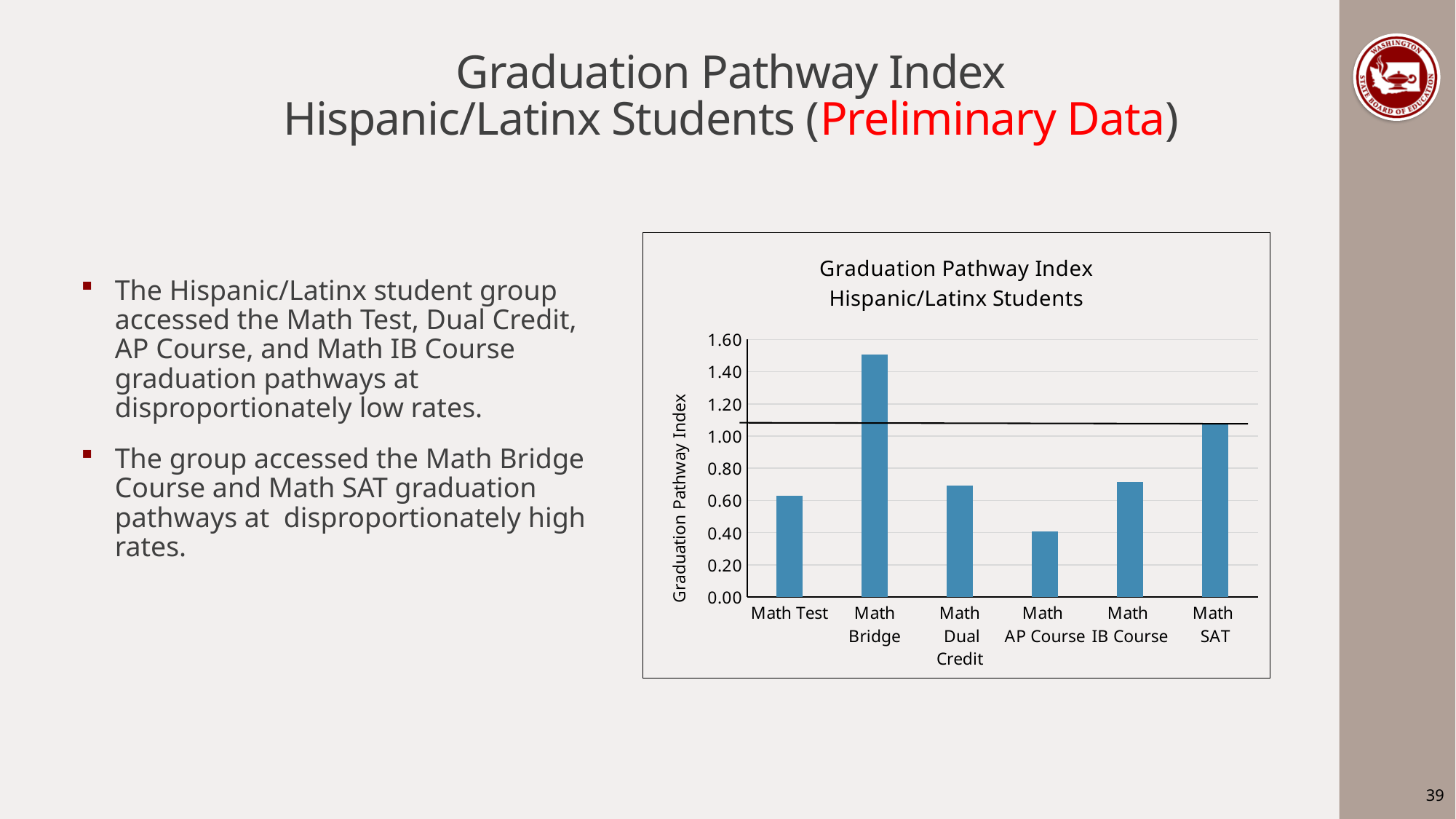
Is the Graduation Pathway Index for Math Test greater or less than 0.40? greater Is the Graduation Pathway Index for Math IB Course greater or less than 0.80? less Which graduation pathway has the highest Graduation Pathway Index? Math Bridge Which has a higher Graduation Pathway Index, Math Test or Math AP Course? Math Test Is the Graduation Pathway Index for Math SAT greater or less than 1.00? greater Which graduation pathway has the lowest Graduation Pathway Index? Math AP Course What is the label on the vertical axis of the chart? Graduation Pathway Index How many graduation pathways are plotted on the chart? 6 What kind of chart is shown on the slide? bar chart Which has a higher Graduation Pathway Index, Math Bridge or Math SAT? Math Bridge